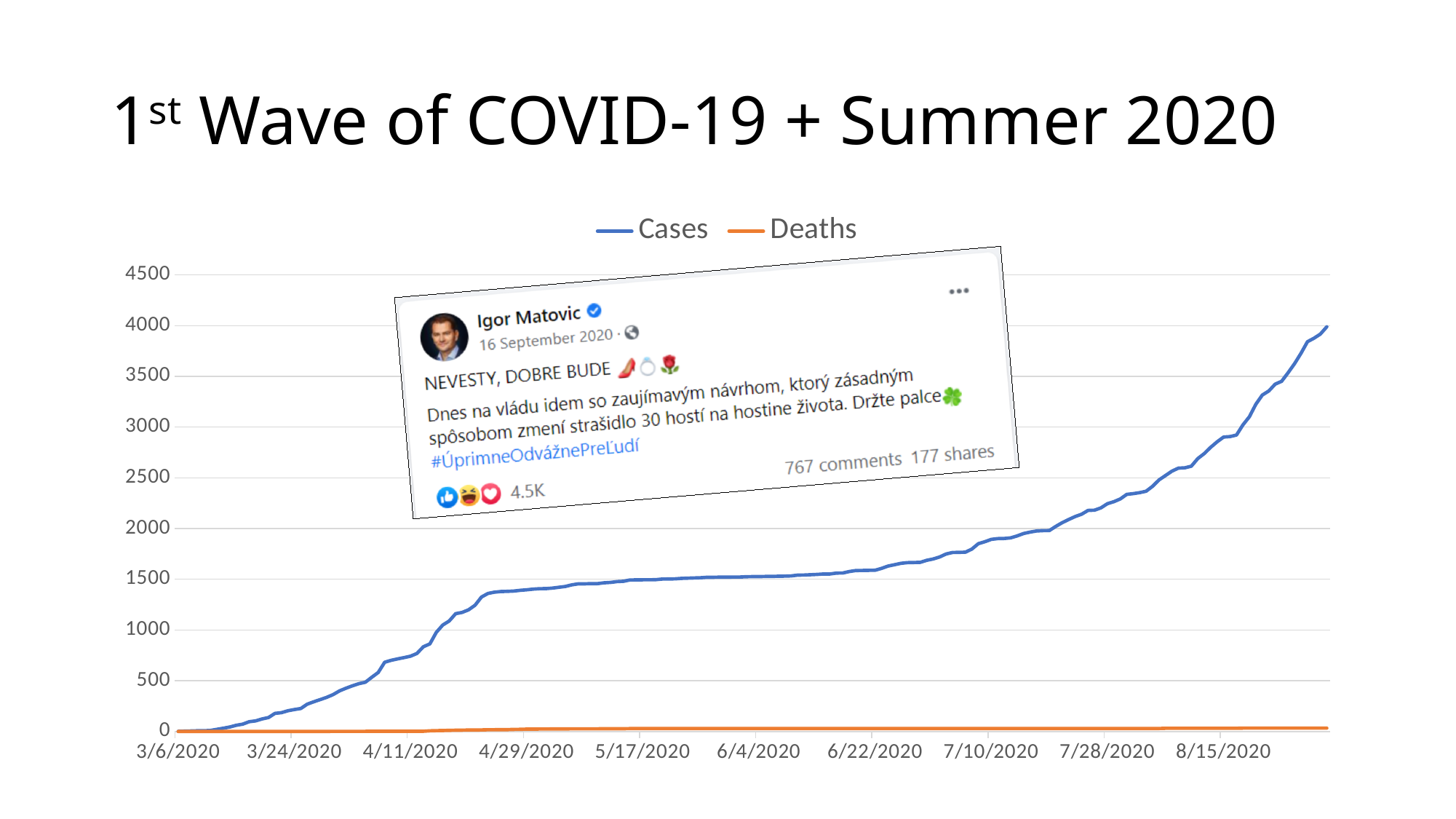
Do the Cases values rise or fall along the x axis from 3/6/2020 onward? rise Is the value for Cases at 7/10/2020 greater or less than 2000? less Is the value for Cases at 4/29/2020 greater or less than 1000? greater What kind of chart is shown on the slide? line chart At 7/28/2020, which series has the larger value, Cases or Deaths? Cases What are the two series named in the chart legend? Cases and Deaths Which series is drawn in blue? Cases How many series does the chart legend list? 2 Is the value for Cases at 4/11/2020 greater or less than 1000? less Which series has the higher values throughout the chart, Cases or Deaths? Cases